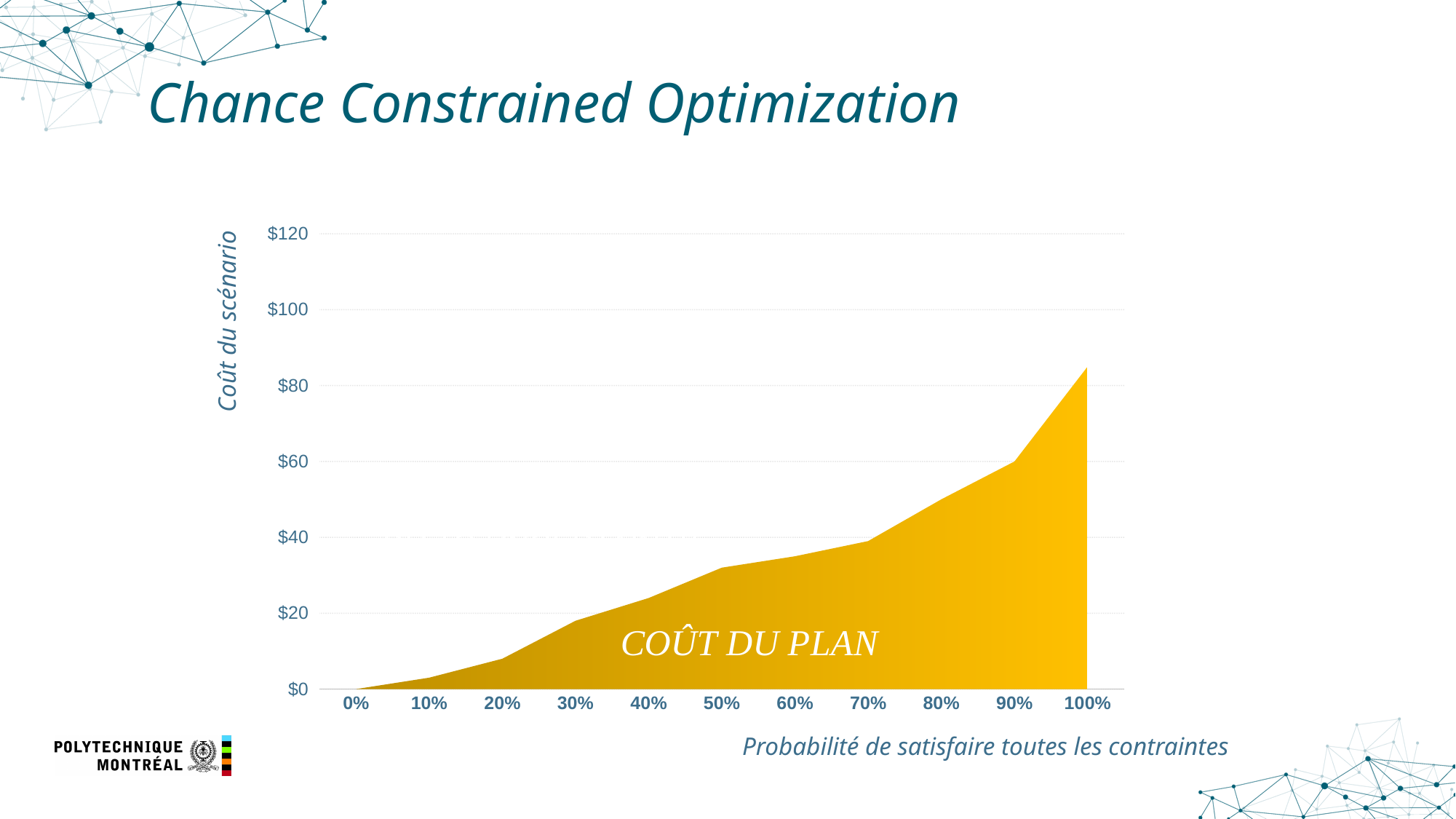
Is the value at 100% greater or less than $80? greater Is the value at 80% greater or less than $40? greater Do the values rise or fall as the probability increases along the x axis? Rise What kind of chart is shown on the slide? Area chart Which is larger, the value at 90% or the value at 60%? 90% What is the title of the x axis? Probabilité de satisfaire toutes les contraintes At which probability is the cost highest? 100% Is the value at 20% greater or less than $20? less At which probability is the cost lowest? 0% What label is written inside the shaded area of the chart? COÛT DU PLAN How many probability points are labelled on the x axis? 11